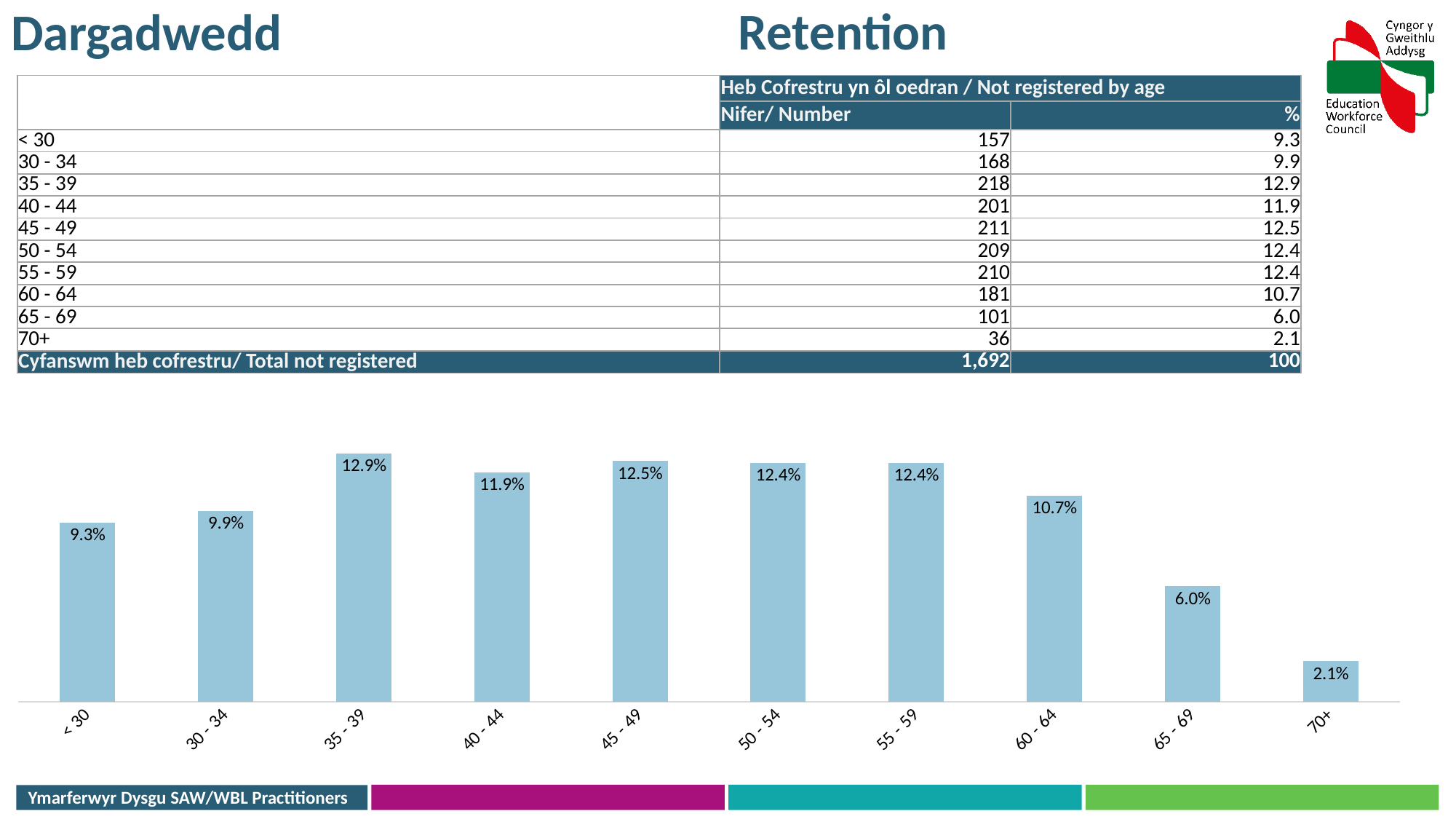
Do the bar values rise or fall from 55 - 59 to 70+ along the x axis? fall Which age group has the lowest bar in the chart? 70+ What is the value shown for the 70+ age group in the bar chart? 2.1% What is the value shown for the 35 - 39 age group in the bar chart? 12.9% How many age groups are plotted in the bar chart? 10 What kind of chart is shown on the slide? bar chart What colour are the bars in the chart? light blue Which age group has the highest bar in the chart? 35 - 39 What is the difference between the values for 35 - 39 and 70+ in the bar chart? 10.8% What is the difference between the values for 60 - 64 and 65 - 69 in the bar chart? 4.7% What is the value shown for the < 30 age group in the bar chart? 9.3% Which is larger in the bar chart, the value for 30 - 34 or the value for 60 - 64? 60 - 64